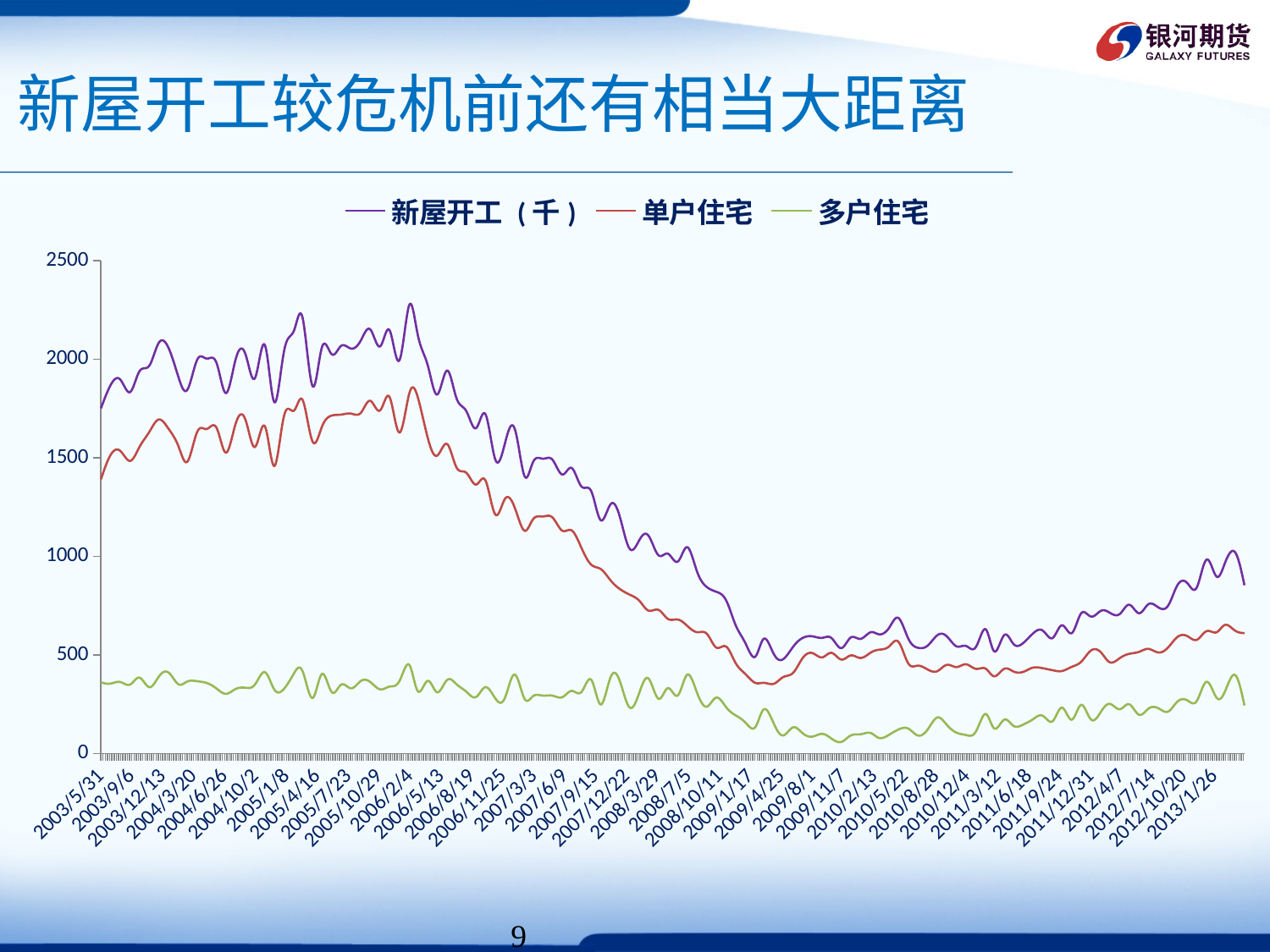
How many series does the legend list? 3 Does the 多户住宅 line ever rise above 500? No Which series has the highest values throughout the chart? 新屋开工（千） Is the value of 单户住宅 around 2009/4/25 greater or less than 500? less What is the highest value shown on the vertical axis? 2500 Is the peak value of 新屋开工（千） near 2006/2/4 greater or less than 2000? greater Which series has the lowest values throughout the chart? 多户住宅 Which is larger at 2009/1/17: 新屋开工（千） or 多户住宅? 新屋开工（千） Does the 新屋开工（千） line rise or fall between 2006/2/4 and 2009/1/17? fall What kind of chart is shown on the slide? line chart Which series is plotted with the green line? 多户住宅